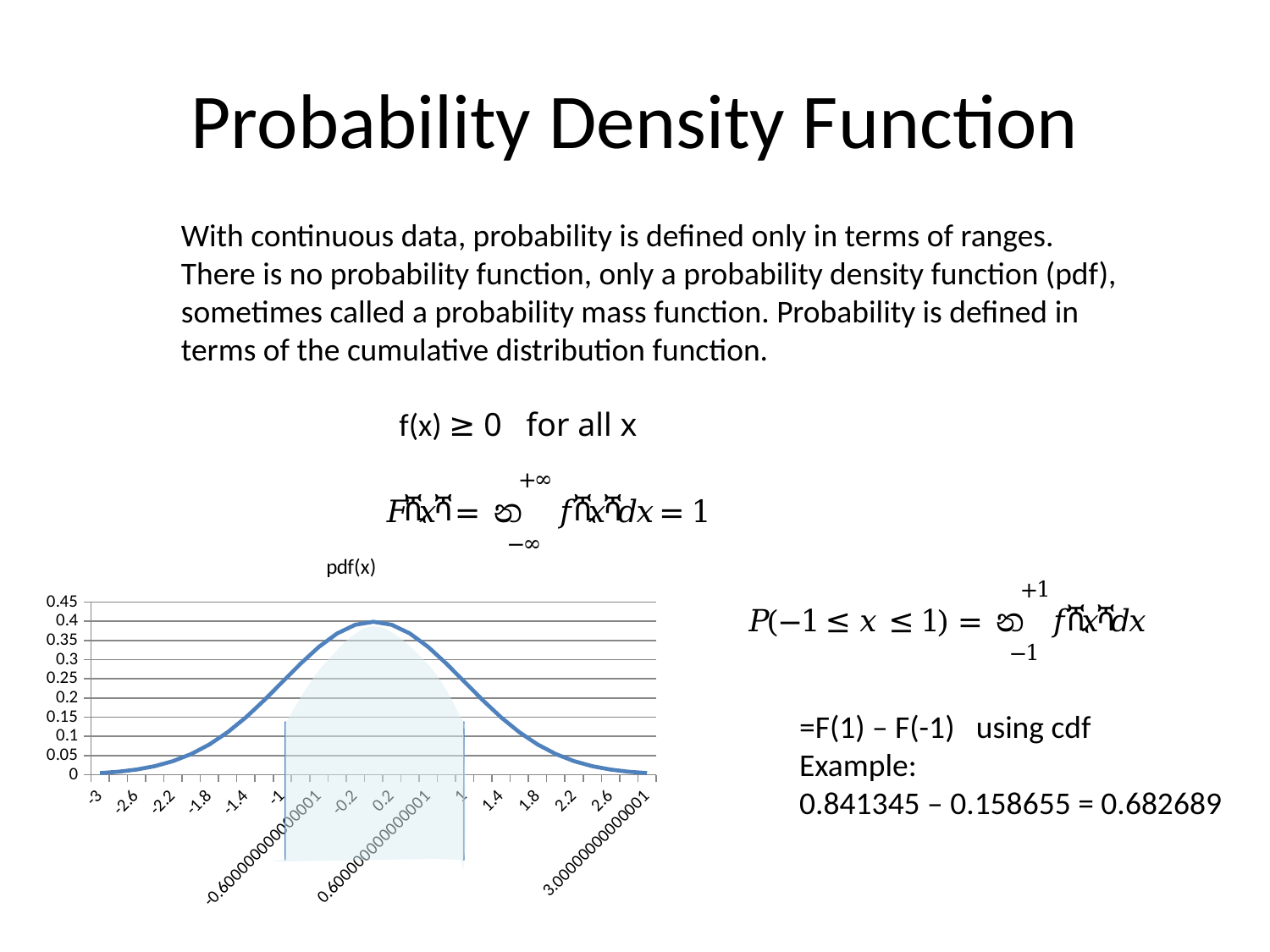
Which has the larger pdf(x) value, x = -1 or x = -2.2? x = -1 Is the value of pdf(x) at x = 1.4 greater or less than 0.2? less Is the value of pdf(x) at x = -1 greater or less than 0.2? greater Is the value of pdf(x) at x = -3 greater or less than 0.05? less Does the pdf(x) curve rise or fall as x goes from 1 to 3? fall What kind of chart is the pdf(x) chart? line chart What is the title of the chart on the slide? pdf(x) What is the highest tick value shown on the y axis of the pdf(x) chart? 0.45 Does the pdf(x) curve rise or fall as x goes from -3 to -0.2? rise